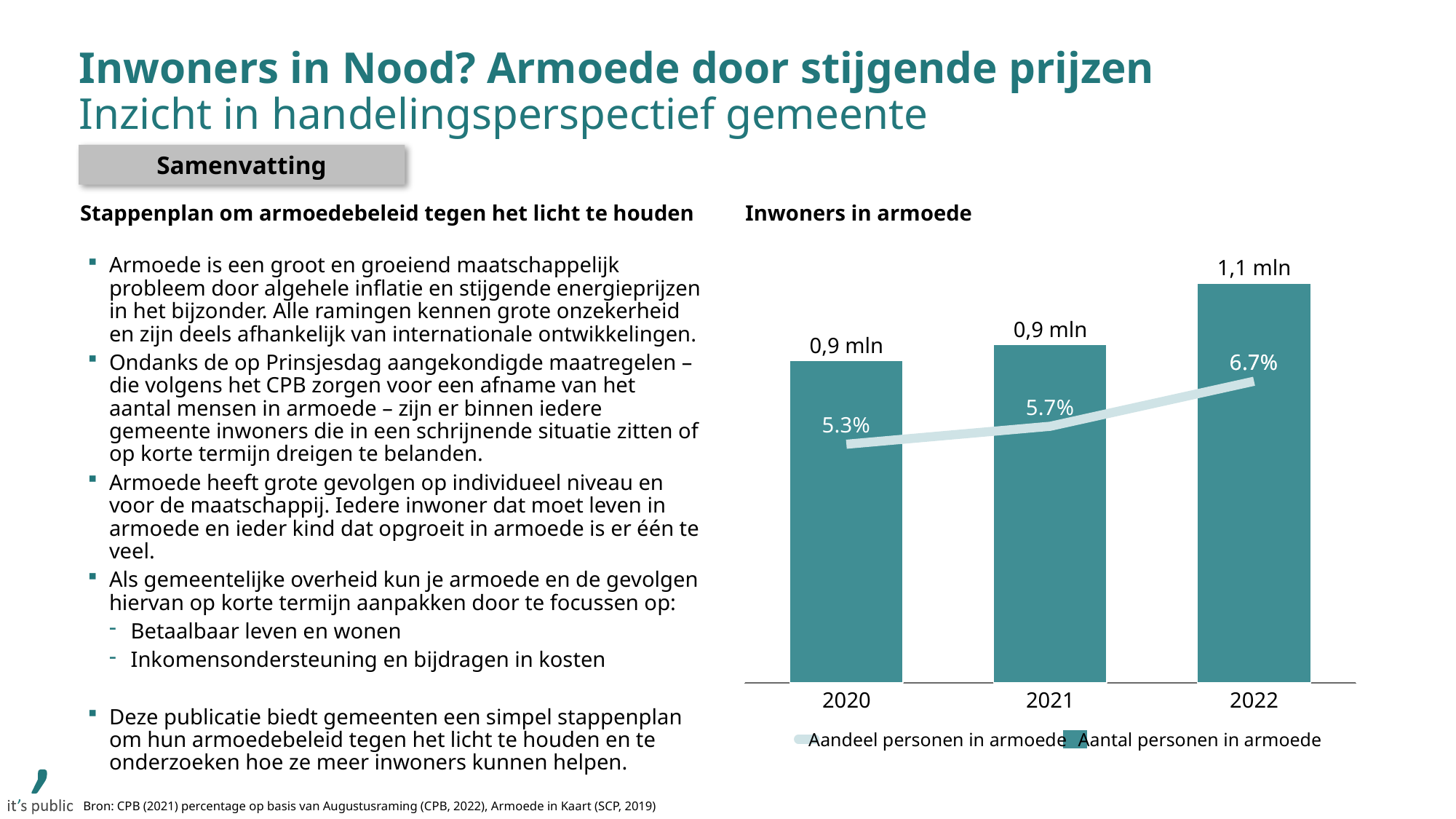
What is the share of persons in poverty (Aandeel personen in armoede) shown for 2021? 5.7% In which year is the share of persons in poverty (Aandeel personen in armoede) lowest? 2020 Does the share of persons in poverty rise or fall from 2020 to 2022? rise In which year is the share of persons in poverty (Aandeel personen in armoede) highest? 2022 What is the number of persons in poverty (Aantal personen in armoede) shown for 2022? 1,1 mln Which year has a larger number of persons in poverty, 2021 or 2022? 2022 How many series does the chart legend list? 2 What is the share of persons in poverty (Aandeel personen in armoede) shown for 2020? 5.3% What is the difference in the share of persons in poverty between 2022 and 2020? 1.4% How many years are shown on the x axis of the chart? 3 What is the title of the chart on the slide? Inwoners in armoede What is the number of persons in poverty (Aantal personen in armoede) shown for 2020? 0,9 mln